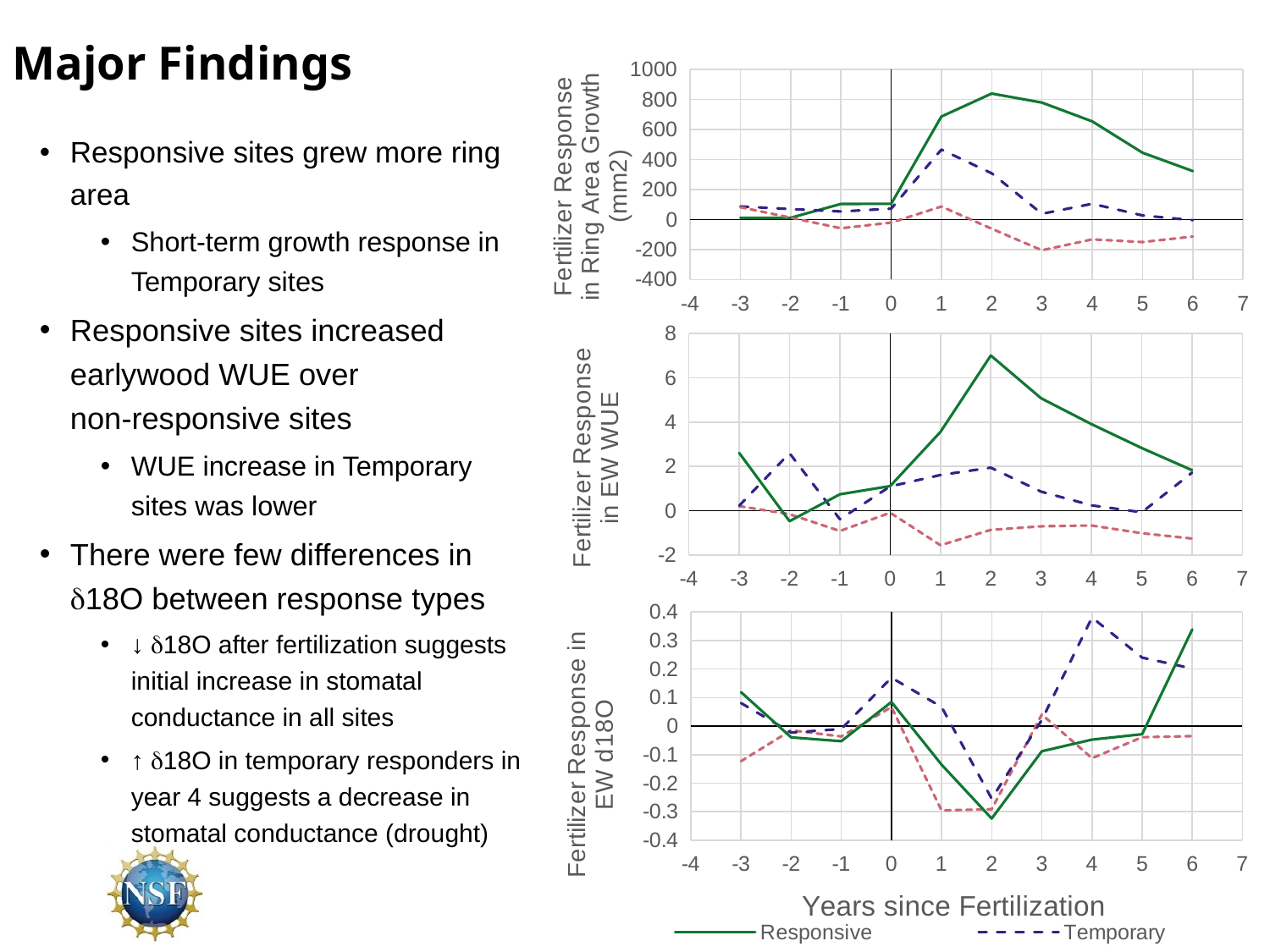
What kind of chart is the top chart (Fertilizer Response in Ring Area Growth)? line chart In the top chart (Fertilizer Response in Ring Area Growth), at which year since fertilization does the Responsive series reach its highest value? 2 In the middle chart (Fertilizer Response in EW WUE), is the Responsive value at year 2 greater or less than 6? greater In the top chart (Fertilizer Response in Ring Area Growth), which series has the larger value at year 2, Responsive or Temporary? Responsive In the bottom chart (Fertilizer Response in EW d18O), is the Temporary value at year 4 greater or less than 0.3? greater In the middle chart (Fertilizer Response in EW WUE), at which year since fertilization does the Responsive series reach its highest value? 2 What is the x-axis title shared by the three charts? Years since Fertilization In the top chart (Fertilizer Response in Ring Area Growth), is the Responsive value at year 2 greater or less than 600? greater In the bottom chart (Fertilizer Response in EW d18O), at which year since fertilization does the Responsive series reach its lowest value? 2 In the top chart (Fertilizer Response in Ring Area Growth), does the Responsive series rise or fall from year 2 to year 6? fall How many series does the legend at the bottom of the slide list? 2